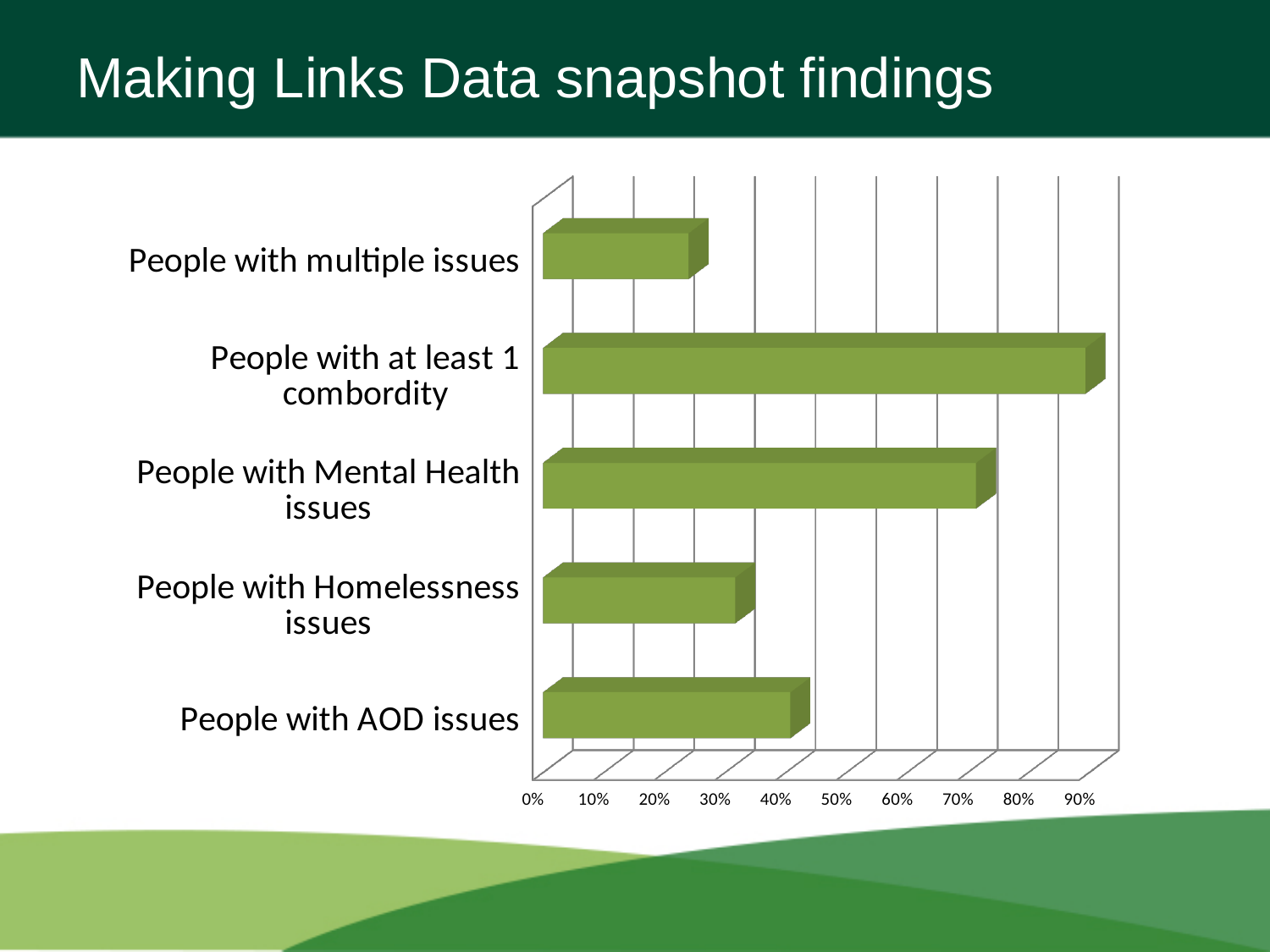
How many categories are plotted in the chart? 5 Is the value for People with Mental Health issues greater or less than 60%? greater Is the value for People with multiple issues greater or less than 30%? less Which category has the highest value in the chart? People with at least 1 combordity Is the value for People with at least 1 combordity greater or less than 80%? greater What colour are the bars in the chart? Green Which category has the lowest value in the chart? People with multiple issues Which is larger: the value for People with AOD issues or the value for People with Homelessness issues? People with AOD issues What kind of chart is shown on the slide? Bar chart Which is larger: the value for People with Mental Health issues or the value for People with Homelessness issues? People with Mental Health issues